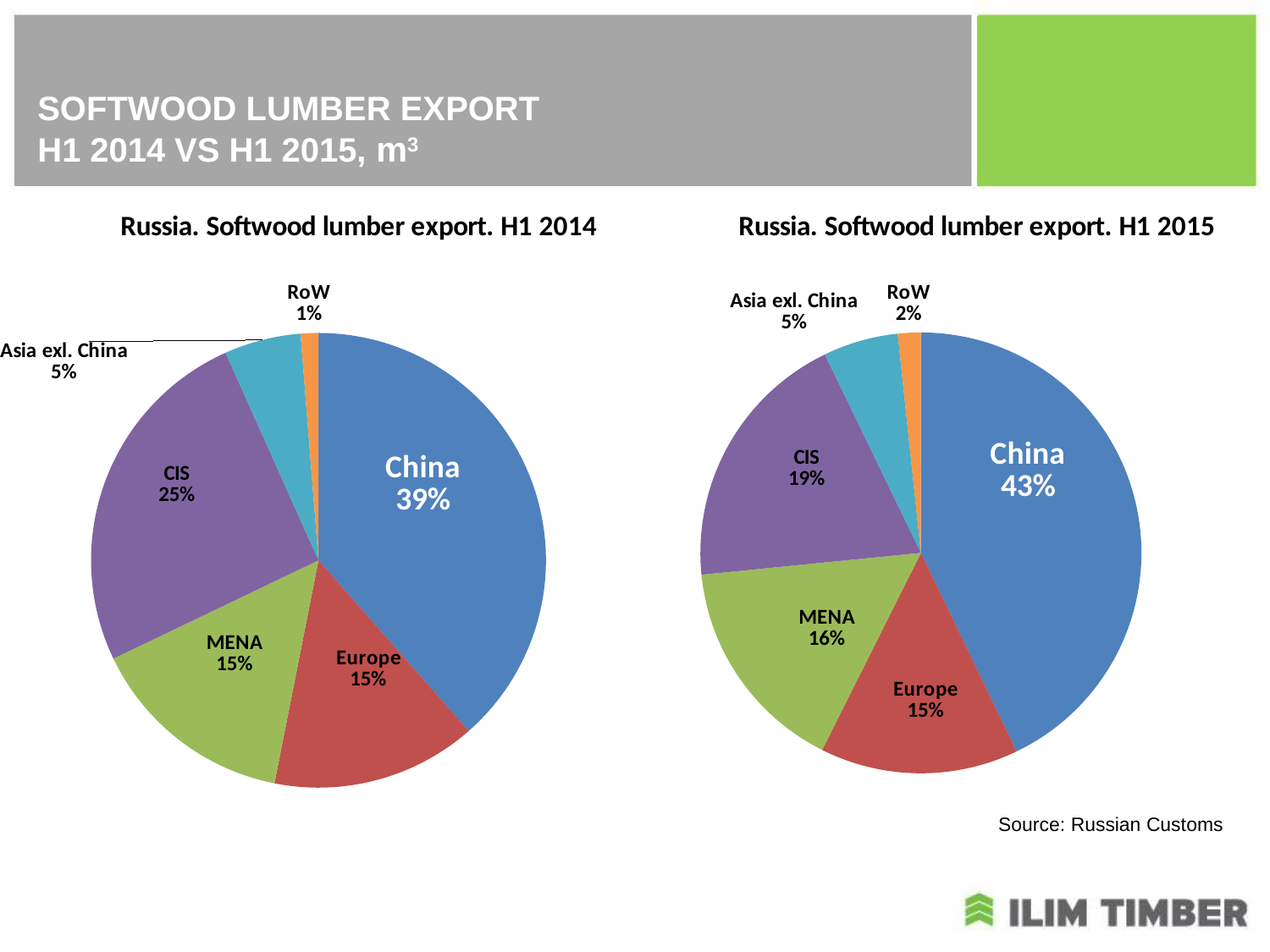
In the 'Russia. Softwood lumber export. H1 2015' chart, which region has the smallest share? RoW In the 'Russia. Softwood lumber export. H1 2015' chart, which is larger, the share for CIS or the share for MENA? CIS In the 'Russia. Softwood lumber export. H1 2014' chart, what share does China have? 39% In the 'Russia. Softwood lumber export. H1 2015' chart, what is the share for RoW? 2% In the 'Russia. Softwood lumber export. H1 2015' chart, what share does China have? 43% In the 'Russia. Softwood lumber export. H1 2014' chart, which region has the largest share? China What kind of chart is the 'Russia. Softwood lumber export. H1 2015' chart? Pie chart In the 'Russia. Softwood lumber export. H1 2015' chart, what is the share for CIS? 19% In the 'Russia. Softwood lumber export. H1 2014' chart, what is the difference between the shares of China and CIS? 14% In the 'Russia. Softwood lumber export. H1 2014' chart, what is the share for CIS? 25% In the 'Russia. Softwood lumber export. H1 2015' chart, what is the share for MENA? 16% How many slices does the 'Russia. Softwood lumber export. H1 2014' chart have? 6